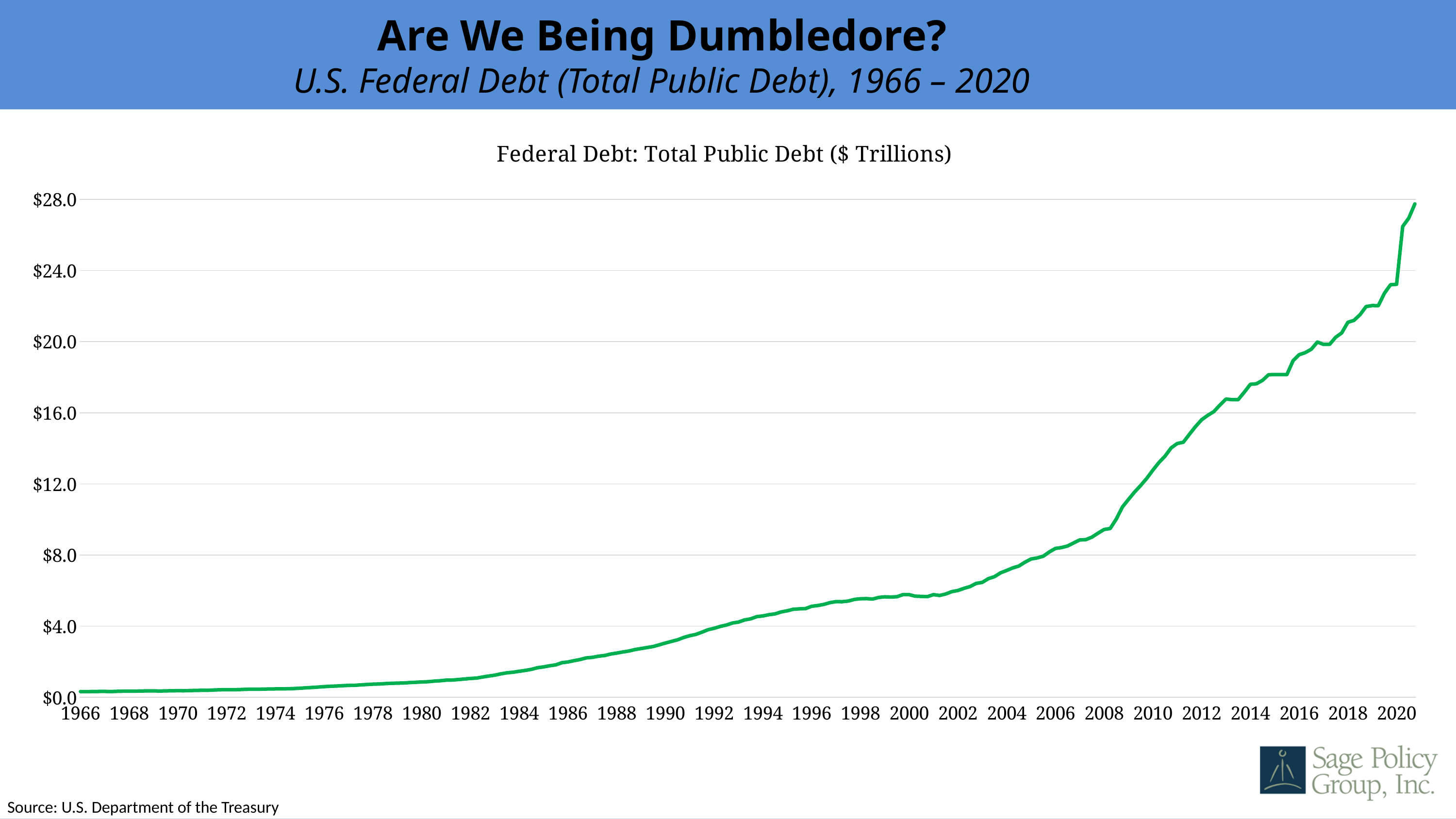
What kind of chart is shown on the slide? Line chart Is the federal debt in 2008 greater or less than $12.0 trillion? less What is the title of the chart? Federal Debt: Total Public Debt ($ Trillions) Does the federal debt generally rise or fall from 1966 to 2020? Rise In which year shown on the x axis is the federal debt highest? 2020 What source is cited for the chart data? U.S. Department of the Treasury In which year shown on the x axis is the federal debt lowest? 1966 Is the federal debt in 2014 greater or less than $16.0 trillion? greater Which year has the larger federal debt, 1980 or 2010? 2010 Is the federal debt in 1990 greater or less than $4.0 trillion? less